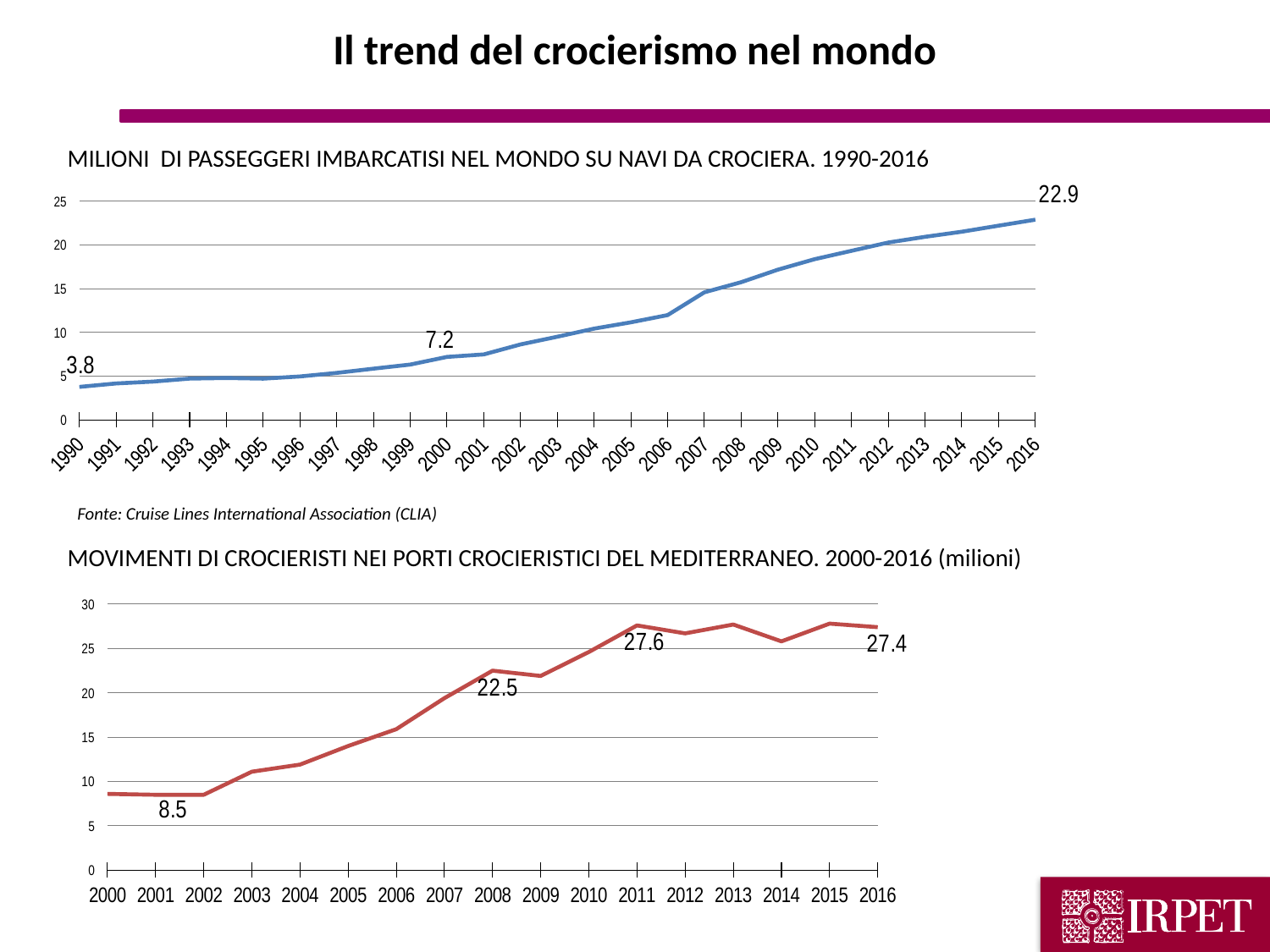
In the top chart, what is the value for 1990? 3.8 In the bottom chart, how many years are shown on the x axis? 17 In the top chart, is the value for 2010 greater or less than 15? greater In the top chart, do the values rise or fall from 1990 to 2016? Rise In the top chart (MILIONI DI PASSEGGERI IMBARCATISI NEL MONDO SU NAVI DA CROCIERA), what is the value for 2016? 22.9 In the top chart, what is the difference between the 2016 value and the 2000 value? 15.7 In the bottom chart (MOVIMENTI DI CROCIERISTI NEI PORTI CROCIERISTICI DEL MEDITERRANEO), what is the value for 2011? 27.6 In the bottom chart, what is the value for 2008? 22.5 What kind of chart is the top chart? Line chart In the top chart, what is the value for 2000? 7.2 In the top chart, what is the difference between the 2016 value and the 1990 value? 19.1 In the bottom chart, what is the value for 2016? 27.4